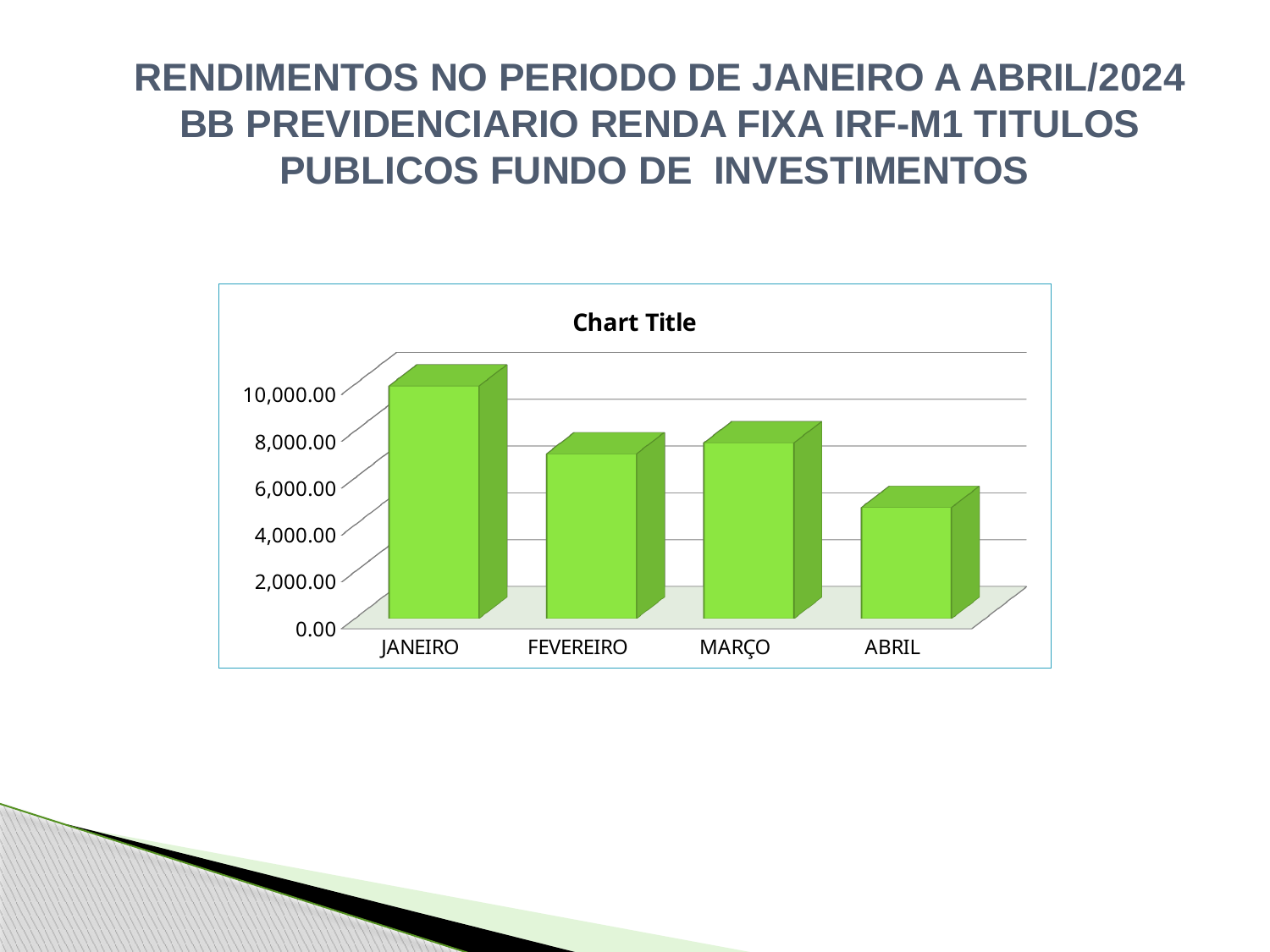
What colour are the bars in the chart? green Which month has the highest bar in the chart? JANEIRO Is the value for ABRIL greater or less than 6,000.00? less Which is larger, the value for JANEIRO or the value for ABRIL? JANEIRO Is the value for JANEIRO greater or less than 8,000.00? greater Is the value for ABRIL greater or less than 4,000.00? greater What kind of chart is shown on the slide? bar chart What is the title printed above the chart's plot area? Chart Title Which month has the lowest bar in the chart? ABRIL How many categories are shown on the x axis of the chart? 4